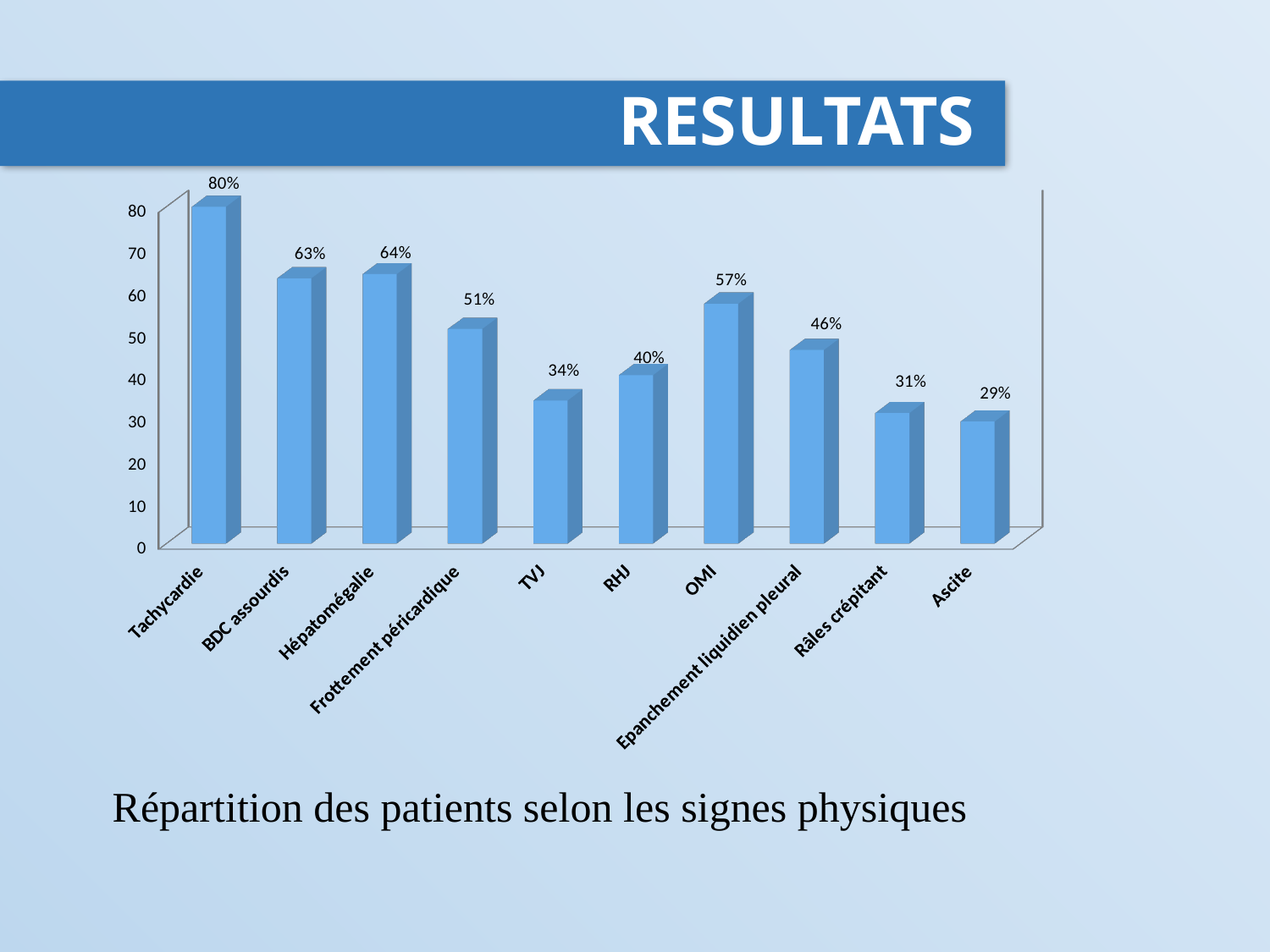
What is the difference between the values for BDC assourdis and Ascite? 34% What is the difference between the values for Hépatomégalie and TVJ? 30% How many categories are shown on the x axis? 10 What kind of chart is shown on the slide? bar chart Which category has the highest value? Tachycardie Which category has the lowest value? Ascite What is the value for OMI? 57% Which is larger, the value for RHJ or the value for Frottement péricardique? Frottement péricardique What is the value for Epanchement liquidien pleural? 46% What is the caption written below the chart? Répartition des patients selon les signes physiques Is the value for Râles crépitant greater or less than 40? less What is the value for Tachycardie? 80%